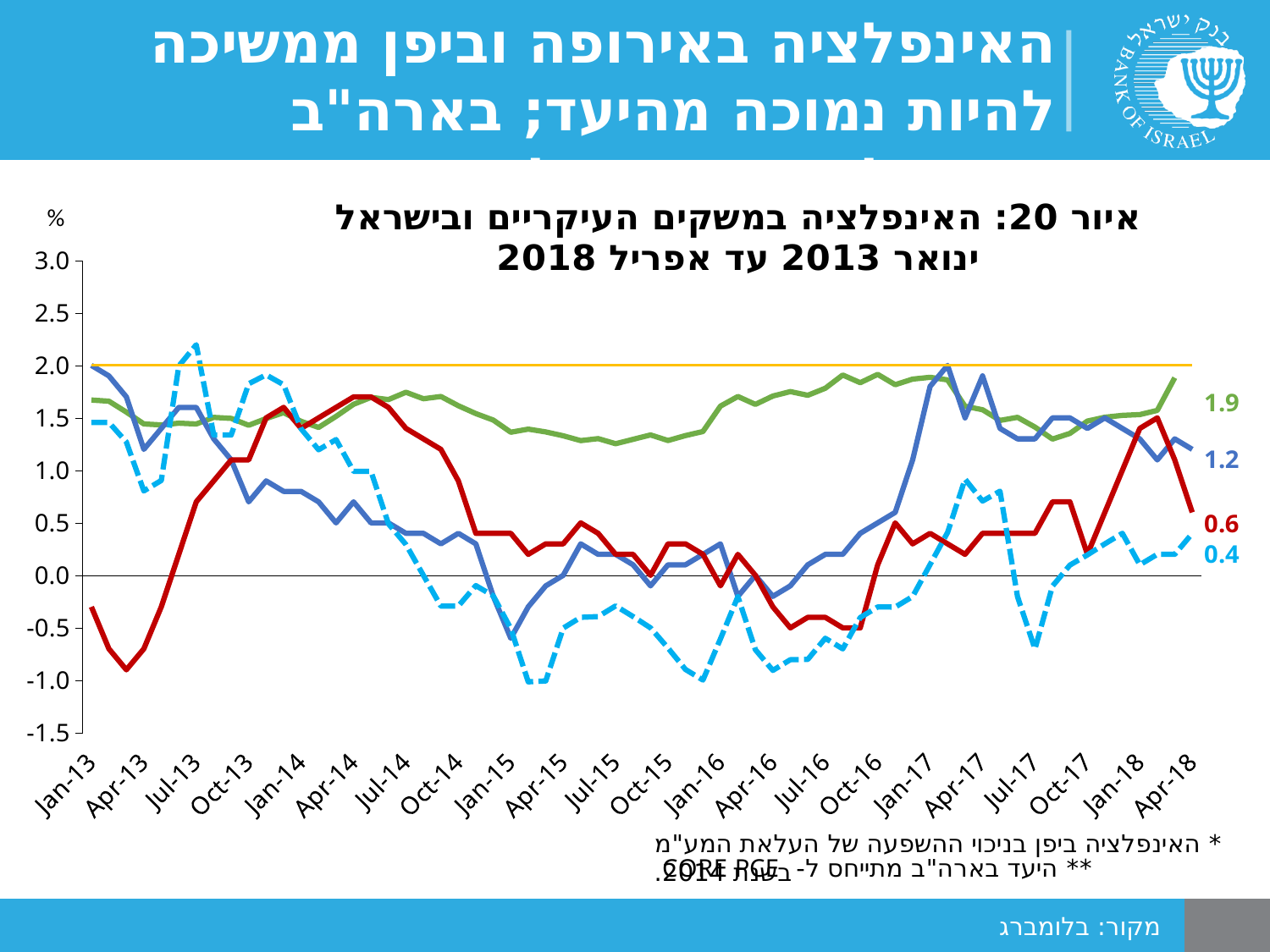
What is the difference between the labelled end values of the green line and the dashed light-blue line? 1.5 What is the final value labelled at the end of the solid blue line? 1.2 Does the red line rise or fall between Jan-18 and Apr-18? fall What is the final value labelled at the end of the dashed light-blue line? 0.4 At what level is the horizontal yellow line drawn on the chart? 2.0 What is the final value labelled at the end of the green line? 1.9 At the end of the chart, is the labelled value of the solid blue line larger or smaller than that of the red line? larger What is the final value labelled at the end of the red line? 0.6 Which line has the highest labelled end value? the green line Is the value of the red line at Apr-13 greater or less than 0.0? less What kind of chart is shown on the slide? line chart Which line has the lowest labelled end value? the dashed light-blue line